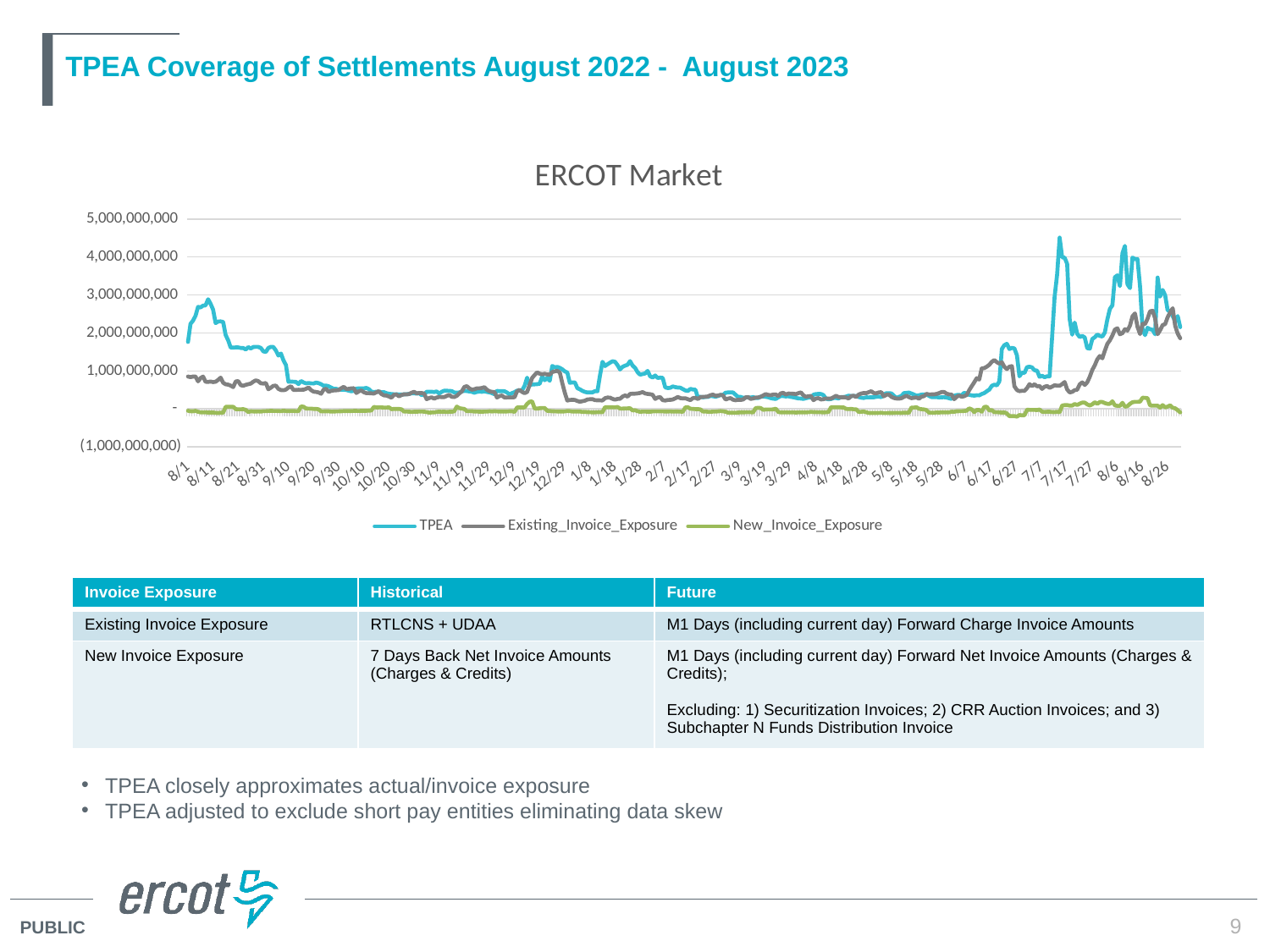
Which series is shown in green in the chart legend? New_Invoice_Exposure What is the highest value shown on the vertical axis? 5,000,000,000 Around 8/11 (at the start of the chart), which is larger: TPEA or Existing_Invoice_Exposure? TPEA Does TPEA generally rise or fall from 8/11 to 9/30 at the start of the chart? fall Which series stays lowest across the chart? New_Invoice_Exposure Is the value of New_Invoice_Exposure ever greater or less than 1,000,000,000 across the chart? less Which series reaches the highest value on the chart? TPEA Is the peak value of TPEA around 7/17 greater or less than 4,000,000,000? greater What is the title of the chart? ERCOT Market Is the TPEA value around 8/11 at the start of the chart greater or less than 2,000,000,000? greater What kind of chart is shown on the slide? Line chart How many series does the chart legend list? 3